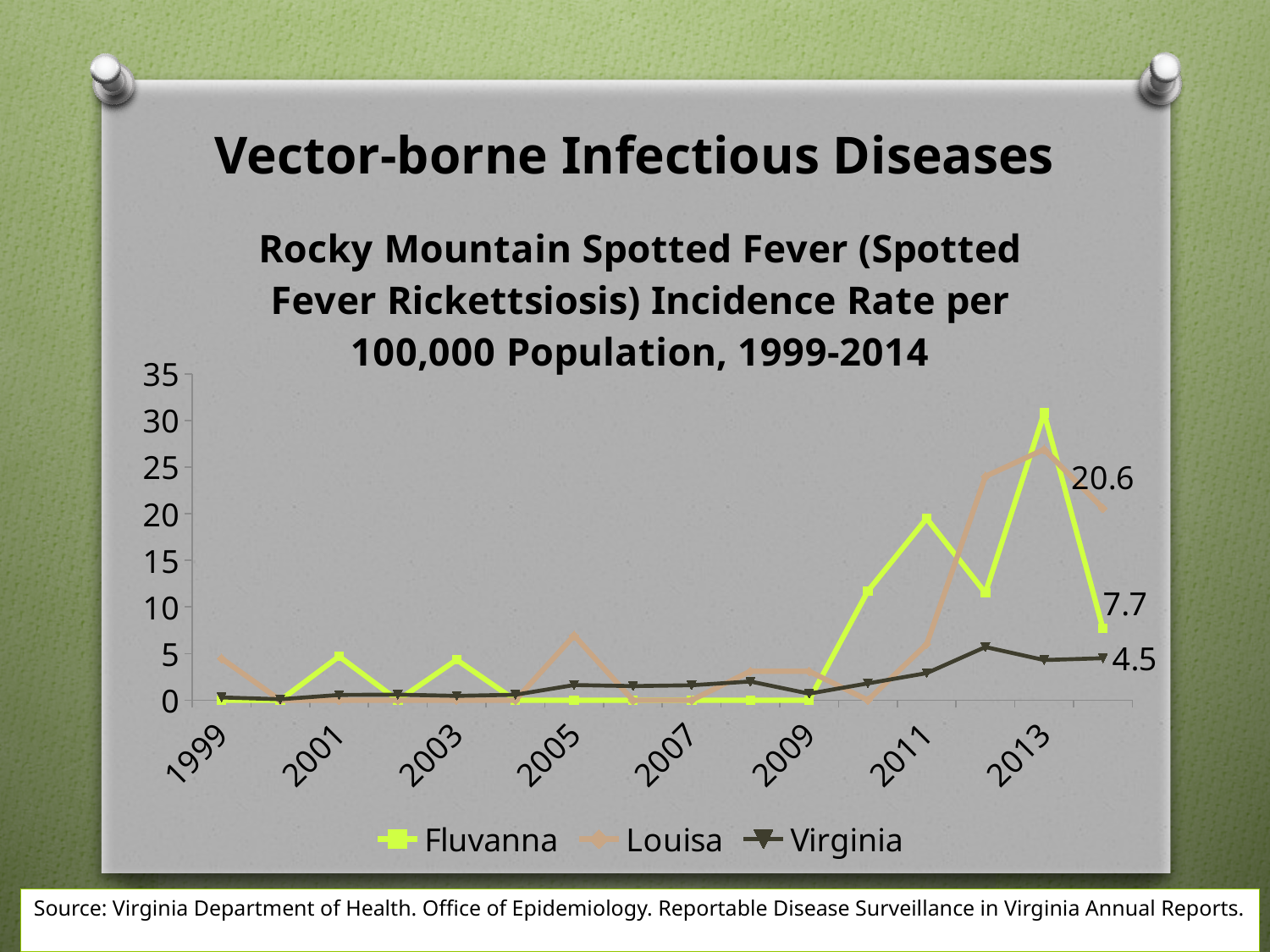
In 2014, which has the larger incidence rate, Louisa or Fluvanna? Louisa Which series is shown in bright green in the legend? Fluvanna Which series has the highest value in 2013? Fluvanna What kind of chart is shown on the slide? Line chart Is the Fluvanna value for 2013 greater or less than 25? greater Is the Virginia value for 2013 greater or less than 10? less How many series does the legend list? 3 In 2014, how much higher is the Louisa rate than the Fluvanna rate? 12.9 What is the Fluvanna incidence rate labelled for 2014? 7.7 What is the Virginia incidence rate labelled for 2014? 4.5 What is the Louisa incidence rate labelled for 2014? 20.6 In 2014, what is the difference between the Fluvanna rate and the Virginia rate? 3.2